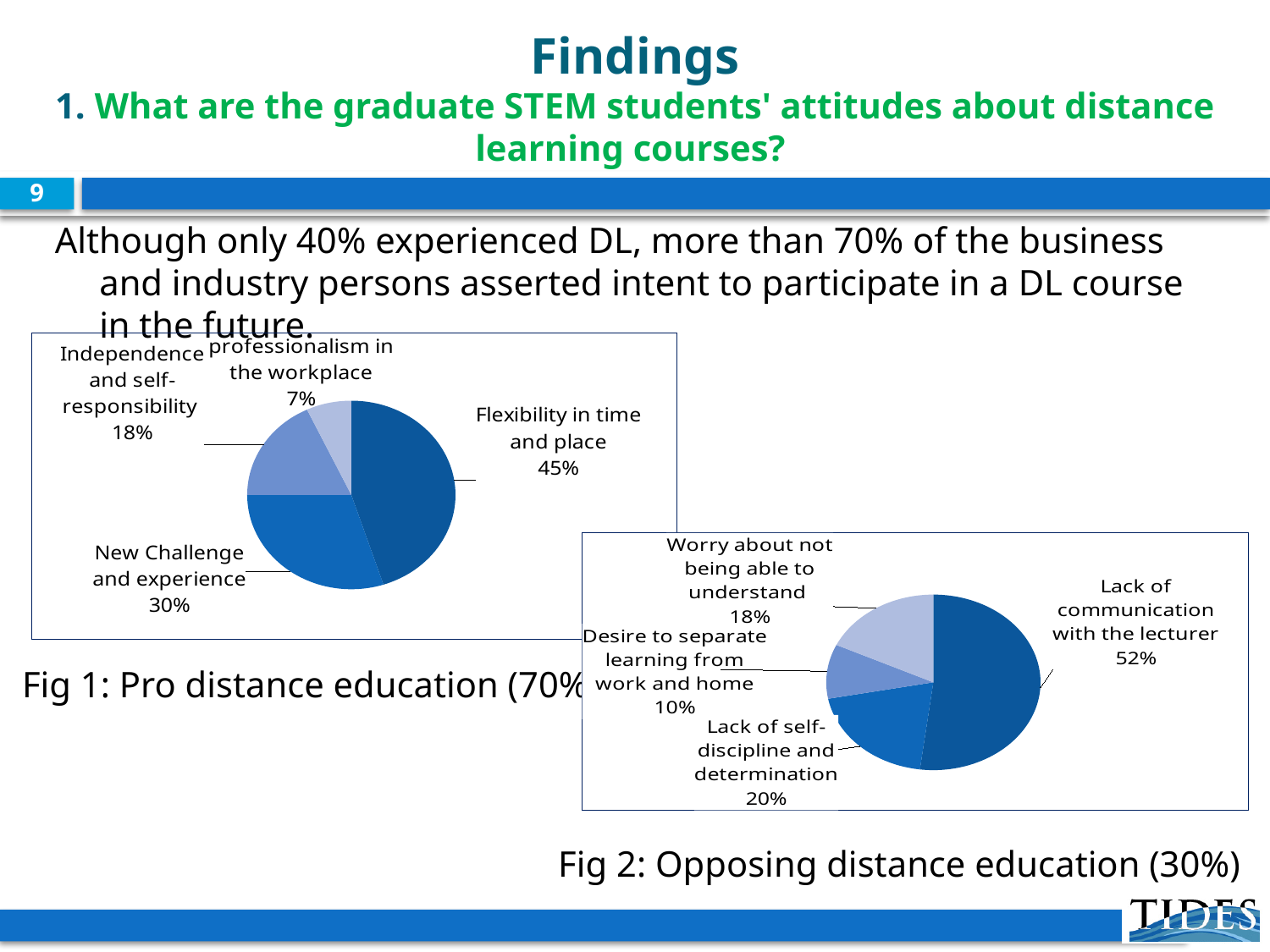
In Fig 1 (Pro distance education), what share is labelled for New Challenge and experience? 30% What kind of chart is Fig 2 (Opposing distance education)? pie chart In Fig 1 (Pro distance education), what share is labelled for Flexibility in time and place? 45% What is the title of the chart on the right of the slide? Fig 2: Opposing distance education (30%) In Fig 2 (Opposing distance education), which category has the largest slice? Lack of communication with the lecturer In Fig 2 (Opposing distance education), what share is labelled for Lack of communication with the lecturer? 52% In Fig 1 (Pro distance education), what is the difference between the shares for Flexibility in time and place and Independence and self-responsibility? 27% In Fig 1 (Pro distance education), which category has the largest slice? Flexibility in time and place In Fig 2 (Opposing distance education), which is larger: Lack of self-discipline and determination or Worry about not being able to understand? Lack of self-discipline and determination In Fig 2 (Opposing distance education), what share is labelled for Desire to separate learning from work and home? 10% In Fig 1 (Pro distance education), how many categories are shown in the pie? 4 In Fig 1 (Pro distance education), which category has the smallest slice? professionalism in the workplace